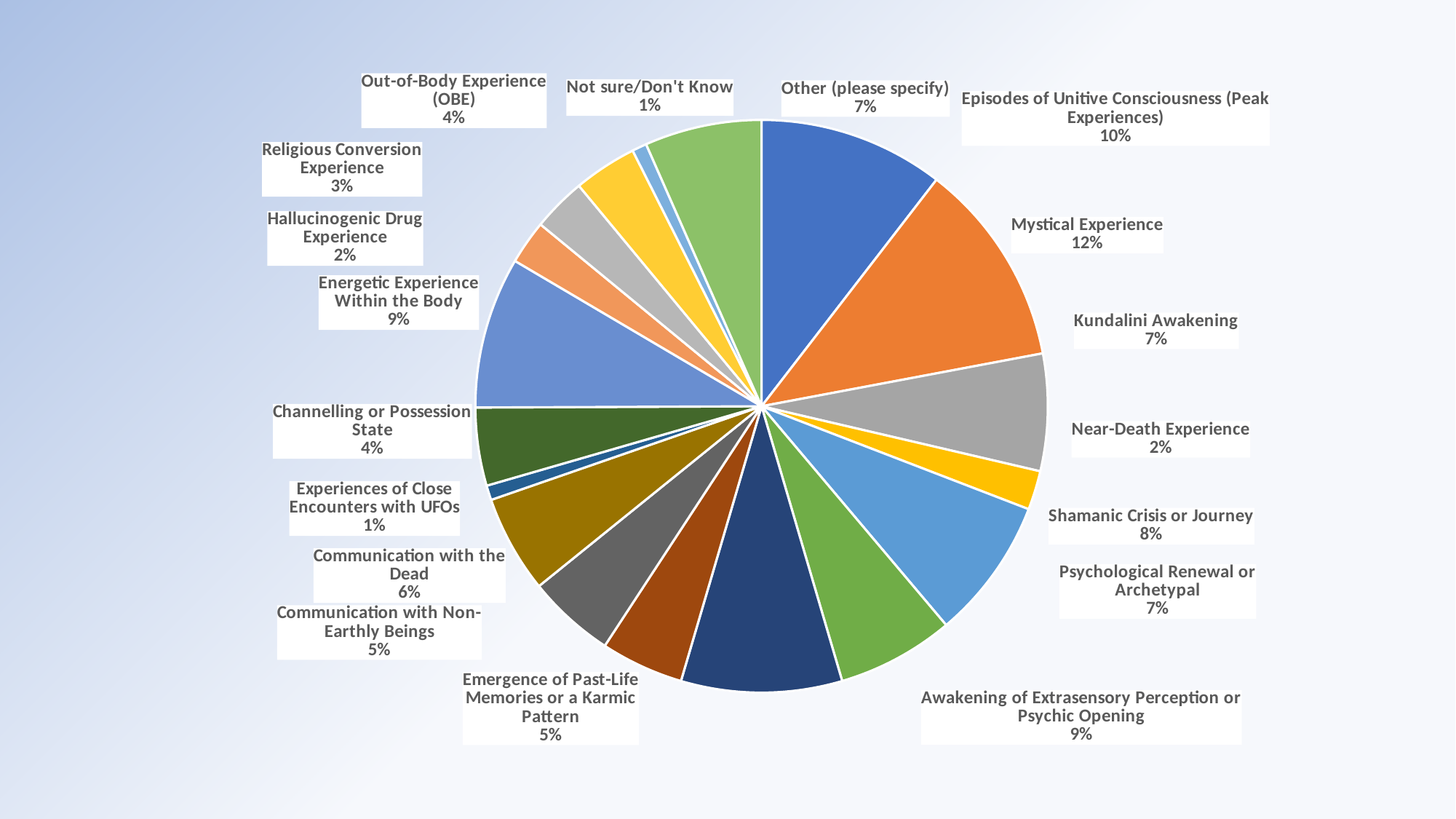
Which is larger, Shamanic Crisis or Journey or Kundalini Awakening? Shamanic Crisis or Journey Which is larger, Communication with the Dead or Communication with Non-Earthly Beings? Communication with the Dead What percentage is shown for Episodes of Unitive Consciousness (Peak Experiences)? 10% What kind of chart is shown on the slide? pie chart What is the difference in percentage points between Mystical Experience and Episodes of Unitive Consciousness (Peak Experiences)? 2 How many categories (slices) does the pie chart have? 18 What share of the pie does Energetic Experience Within the Body have? 9% What percentage is shown for Not sure/Don't Know? 1% How many categories are labelled with 1%? 2 What percentage is shown for Near-Death Experience? 2% What percentage is shown for Mystical Experience? 12% Which category has the largest slice of the pie? Mystical Experience